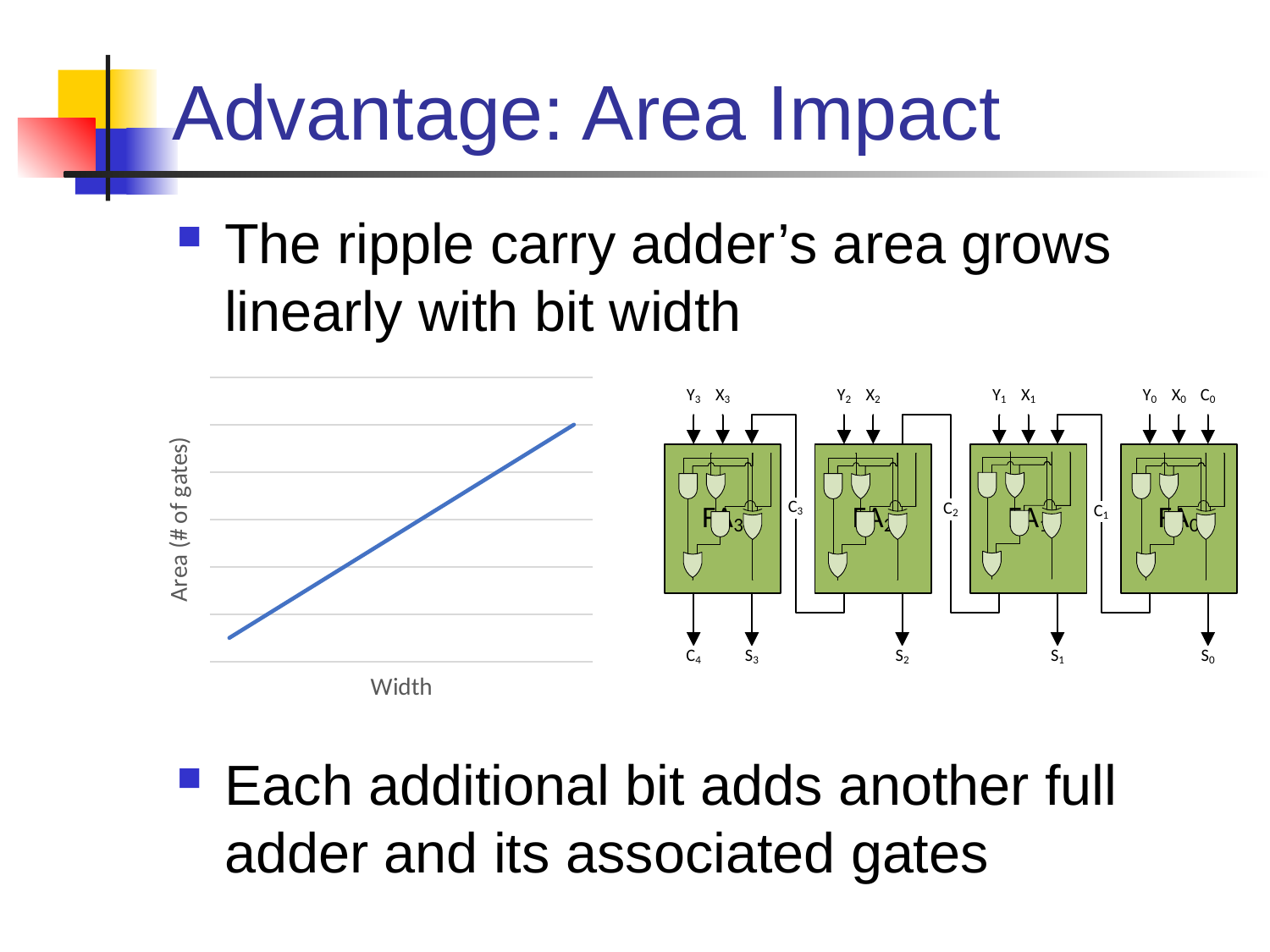
In the chart on the left, does the plotted line rise or fall as width increases along the x axis? rise How many lines are plotted in the chart on the left? 1 What is the label on the horizontal axis of the chart on the left? Width What kind of chart is shown on the left of the slide? line chart What is the label on the vertical axis of the chart on the left? Area (# of gates)